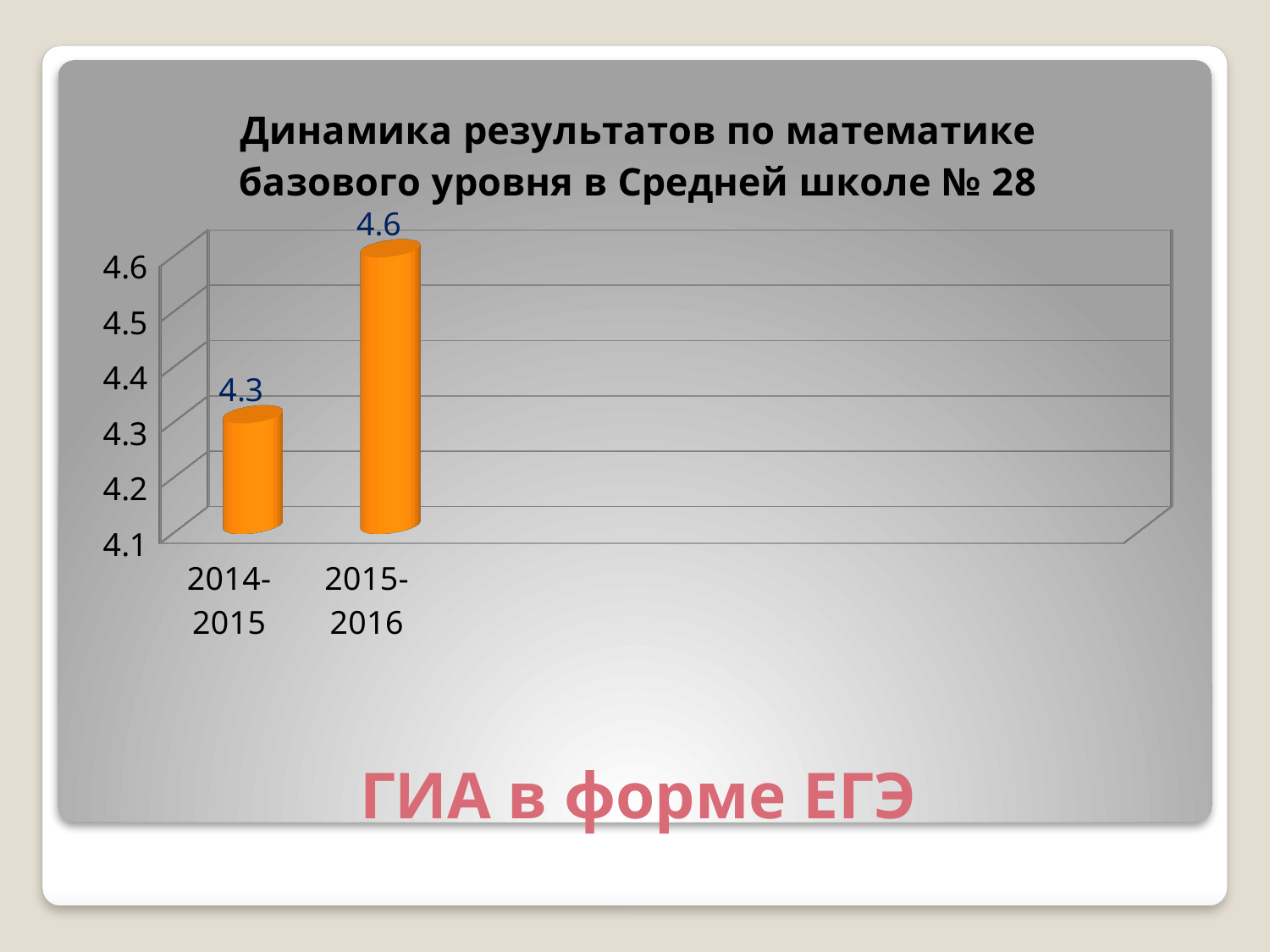
What is the title of the chart? Динамика результатов по математике базового уровня в Средней школе № 28 What is the value for 2015-2016? 4.6 What is the value for 2014-2015? 4.3 Do the values rise or fall from 2014-2015 to 2015-2016? rise What kind of chart is shown on the slide? bar chart Is the value for 2015-2016 greater or less than 4.5? greater Which academic year has the lowest value? 2014-2015 How many categories are shown on the x axis? 2 Which is larger, the value for 2014-2015 or the value for 2015-2016? 2015-2016 Which academic year has the highest value? 2015-2016 Is the value for 2014-2015 greater or less than 4.4? less What is the difference between the values for 2015-2016 and 2014-2015? 0.3